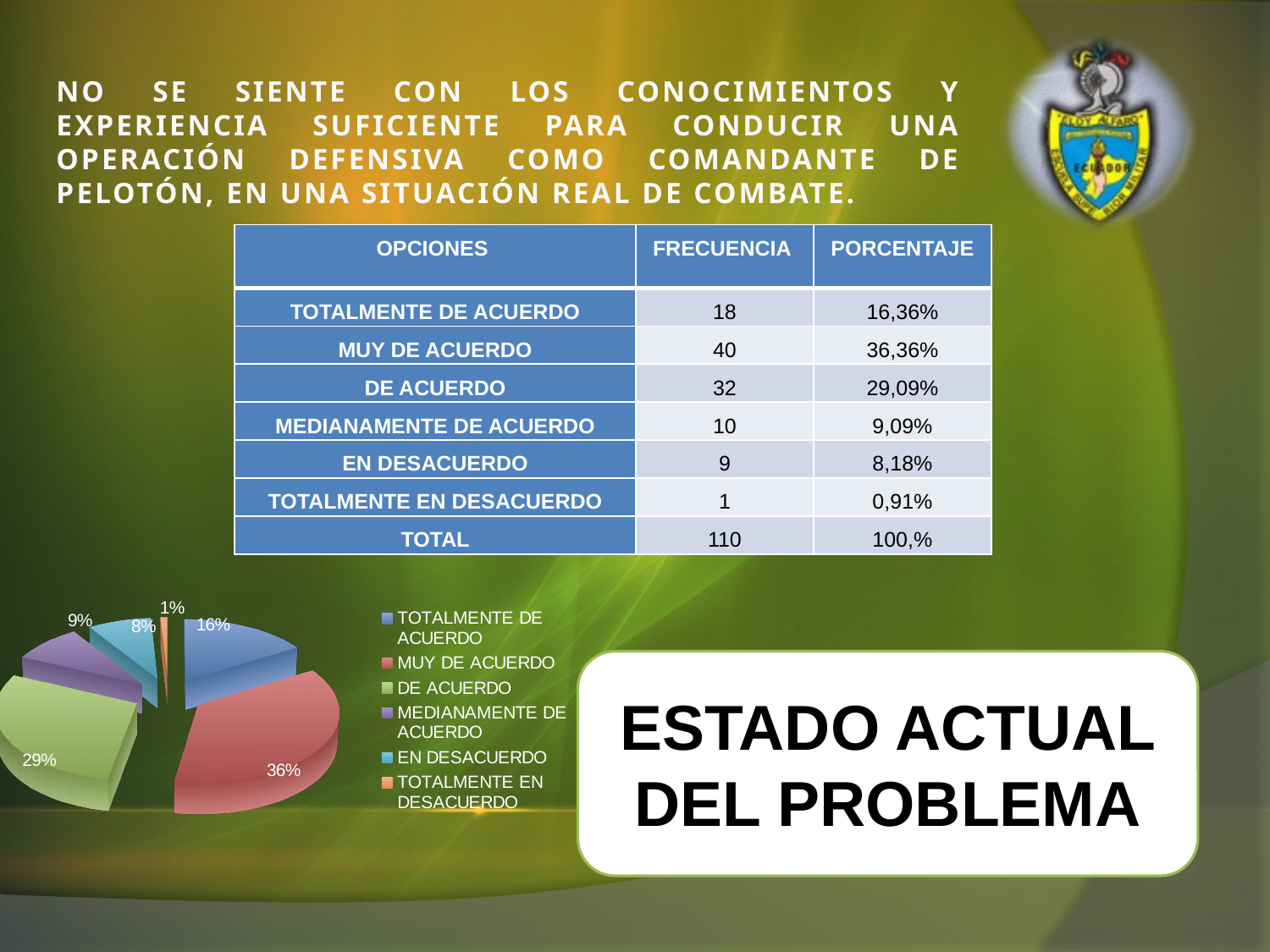
What share of the pie chart does MUY DE ACUERDO take? 36% Which category has the smallest slice in the pie chart? TOTALMENTE EN DESACUERDO Which category has the largest slice in the pie chart? MUY DE ACUERDO Which slice is larger in the pie chart, MEDIANAMENTE DE ACUERDO or EN DESACUERDO? MEDIANAMENTE DE ACUERDO What is the data label for DE ACUERDO in the pie chart? 29% What colour is the MUY DE ACUERDO slice in the pie chart? red How many series does the legend of the pie chart list? 6 What is the data label for TOTALMENTE DE ACUERDO in the pie chart? 16% What kind of chart is shown on the slide? pie chart How many slices does the pie chart have? 6 What is the difference between the MUY DE ACUERDO and DE ACUERDO slices in the pie chart? 7% What is the data label for TOTALMENTE EN DESACUERDO in the pie chart? 1%